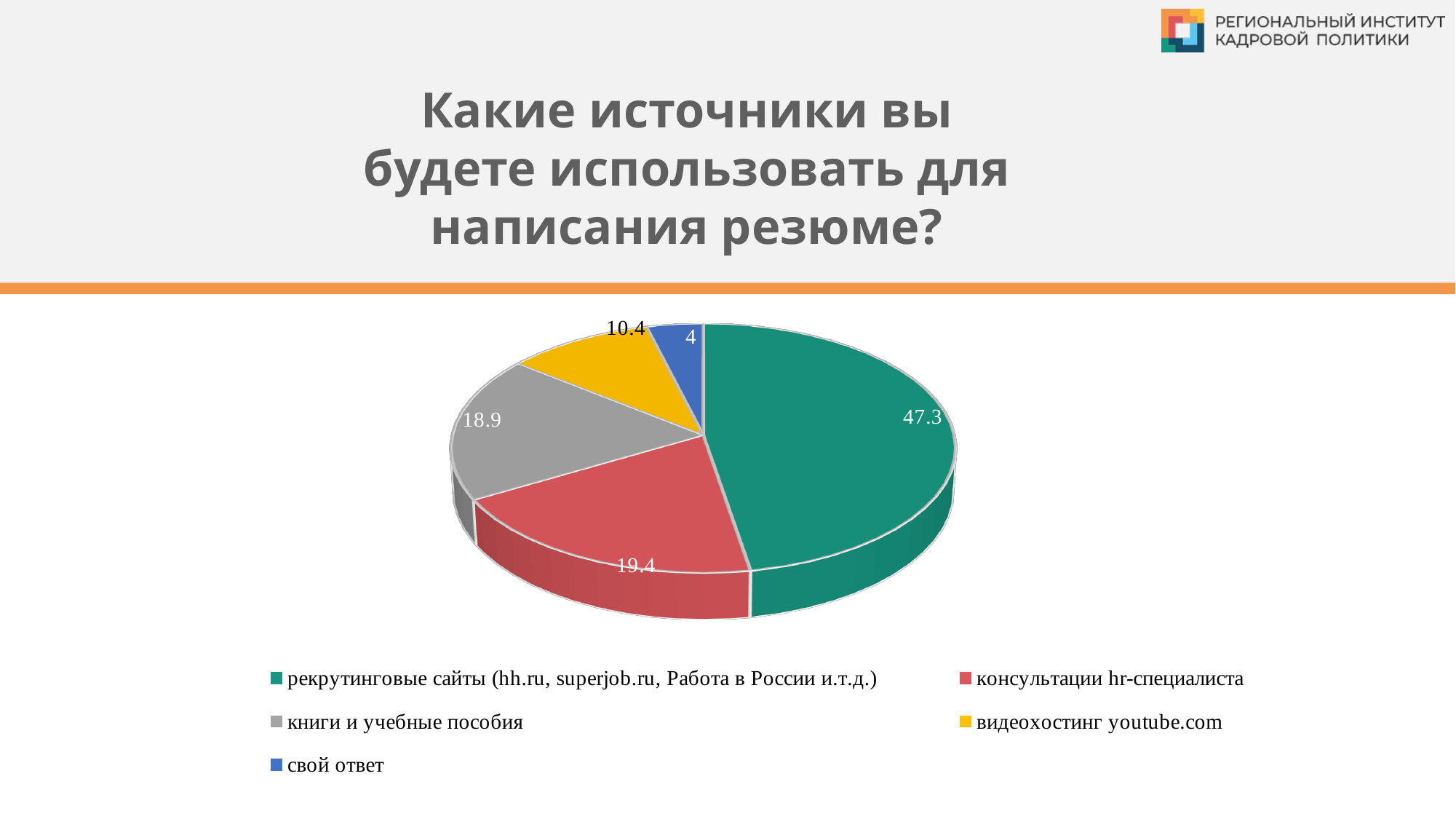
What type of chart is shown on the slide? pie chart What colour is the slice for видеохостинг youtube.com? yellow What is the value for видеохостинг youtube.com? 10.4 What is the value for свой ответ? 4 What is the value for консультации hr-специалиста? 19.4 What is the difference between the values for консультации hr-специалиста and книги и учебные пособия? 0.5 Which category has the smallest slice of the pie? свой ответ Which is larger: the value for рекрутинговые сайты or the value for видеохостинг youtube.com? рекрутинговые сайты Which category has the largest slice of the pie? рекрутинговые сайты (hh.ru, superjob.ru, Работа в России и.т.д.) What is the value for рекрутинговые сайты (hh.ru, superjob.ru, Работа в России и.т.д.)? 47.3 What is the value for книги и учебные пособия? 18.9 How many categories does the pie chart have? 5